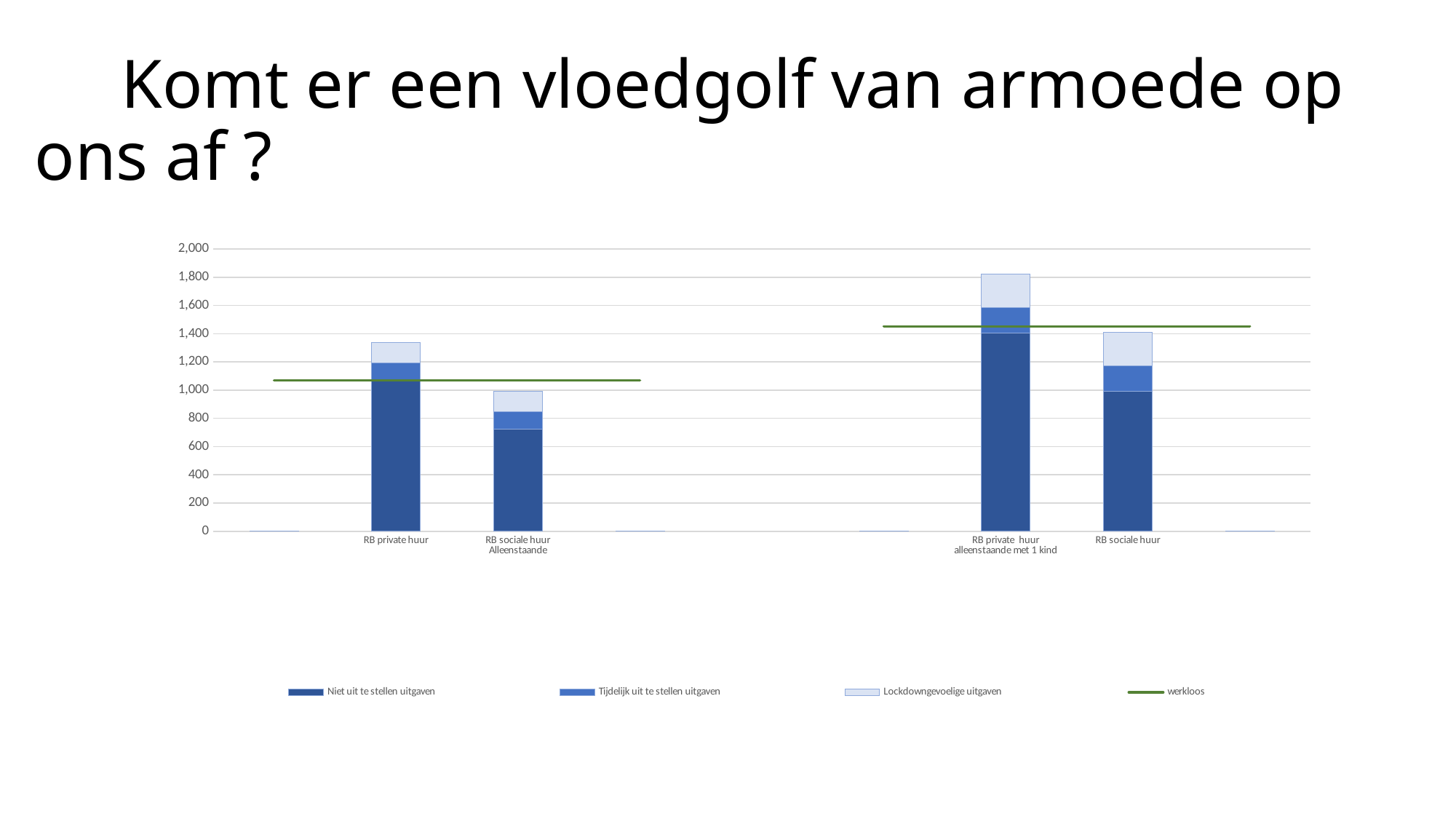
Is the werkloos line for the Alleenstaande group greater or less than 1,000? greater What kind of chart is shown on the slide? Combination chart with stacked bars and a line In the Alleenstaande group, which bar is taller: RB private huur or RB sociale huur? RB private huur Is the Niet uit te stellen uitgaven segment of the RB sociale huur Alleenstaande bar greater or less than 800? less How many stacked bars are plotted in the chart? 4 Is the total value of the RB private huur alleenstaande met 1 kind bar greater or less than 1,600? greater Which legend entry is represented by the green line? werkloos Which bar has the highest total value? RB private huur alleenstaande met 1 kind How many series does the legend list? 4 Which bar has the lowest total value? RB sociale huur Alleenstaande Which legend entry is shown in the darkest blue? Niet uit te stellen uitgaven